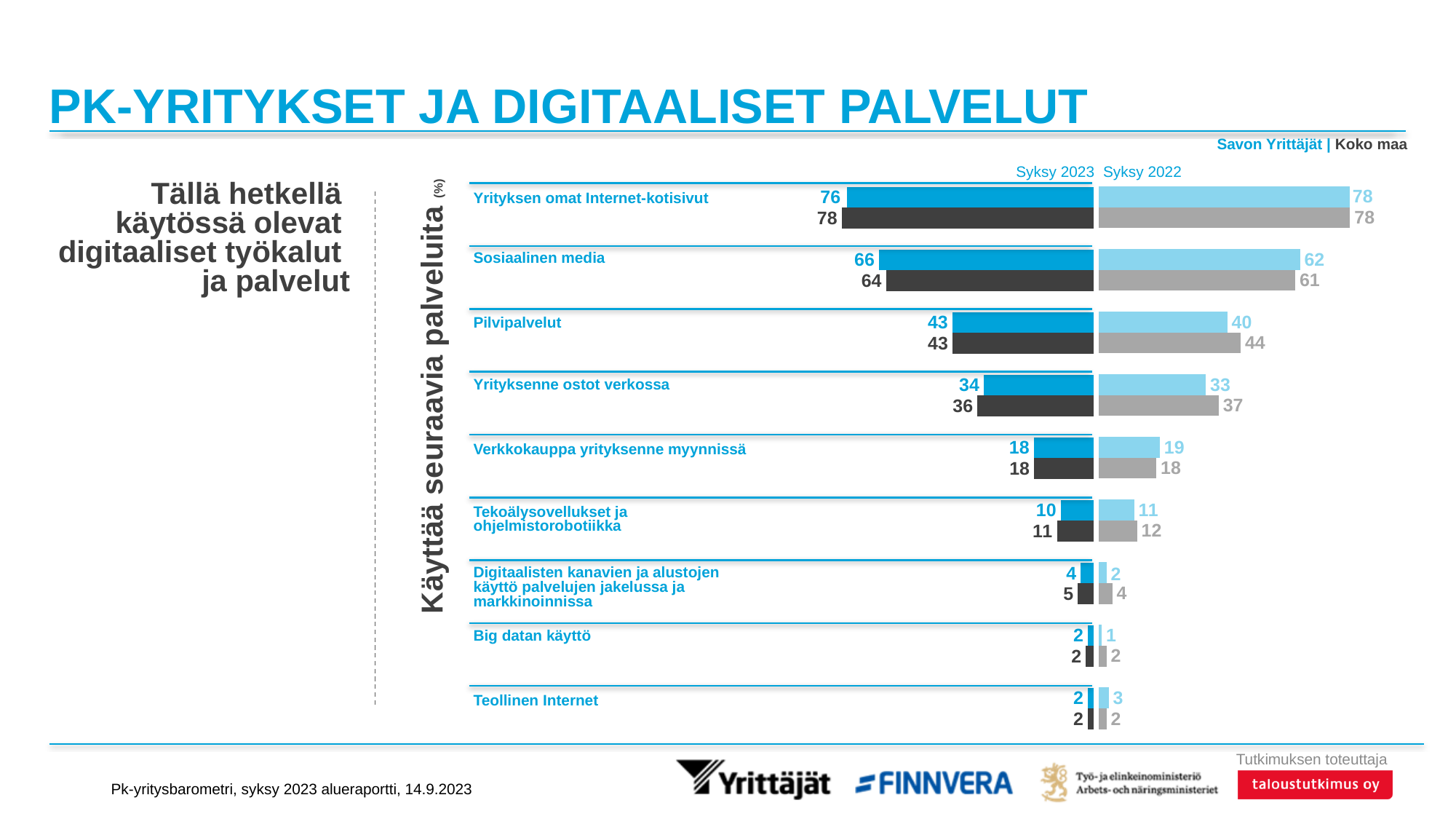
What is the Syksy 2022 value for Koko maa for Sosiaalinen media? 61 For Pilvipalvelut, which is larger in Syksy 2022: Savon Yrittäjät or Koko maa? Koko maa What is the Syksy 2023 value for Savon Yrittäjät for Tekoälysovellukset ja ohjelmistorobotiikka? 10 How many categories are shown in the chart? 9 Which category has the highest Syksy 2023 value for Savon Yrittäjät? Yrityksen omat Internet-kotisivut What is the difference between the Syksy 2023 and Syksy 2022 values for Savon Yrittäjät for Yrityksen omat Internet-kotisivut? 2 Which two survey periods are compared in the chart? Syksy 2023 and Syksy 2022 What is the Syksy 2023 value for Koko maa for Yrityksenne ostot verkossa? 36 What is the difference between the Savon Yrittäjät and Koko maa Syksy 2023 values for Sosiaalinen media? 2 What is the Syksy 2023 value for Savon Yrittäjät for Yrityksen omat Internet-kotisivut? 76 What type of chart is shown on the slide? Bar chart What is the Syksy 2022 value for Savon Yrittäjät for Pilvipalvelut? 40